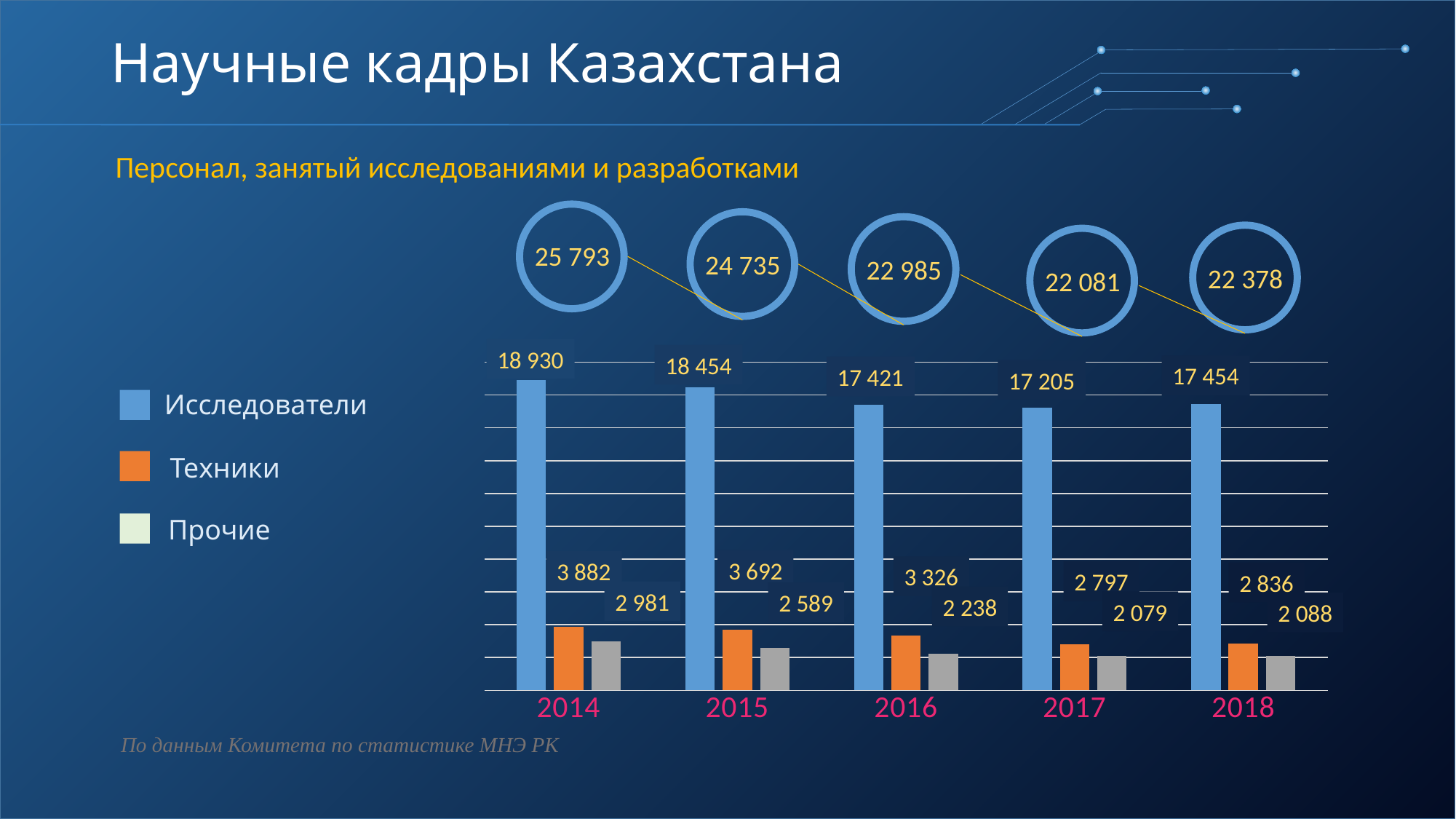
What total is shown in the circle above the 2016 bars? 22 985 What kind of chart is shown on the slide? bar chart What is the value for Исследователи in 2014? 18 930 Which is larger, the Исследователи value in 2017 or in 2018? 2018 Do the values for Техники rise or fall from 2014 to 2017? fall In which year is the value for Исследователи the highest? 2014 How many years are shown on the x axis? 5 What is the value for Прочие in 2018? 2 088 In which year is the value for Прочие the lowest? 2017 How many series does the legend list? 3 What is the value for Техники in 2016? 3 326 What is the difference between the Техники values in 2014 and 2018? 1 046